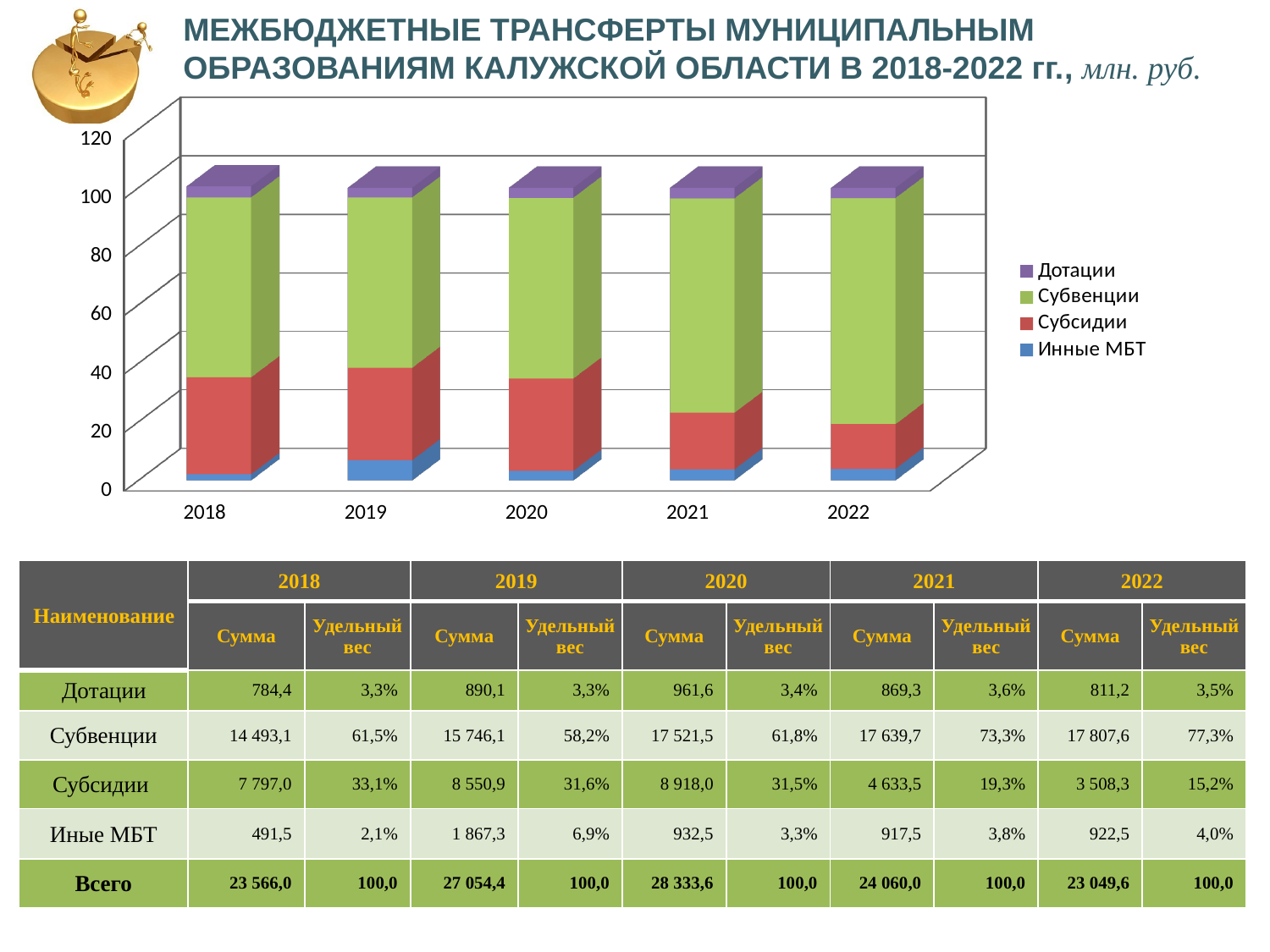
Which series has the smallest share in 2018? Иные МБТ What kind of chart is shown on the slide? Stacked bar chart In which year is the share of Субвенции the highest? 2022 How many series does the chart legend list? 4 Does the share of Субсидии rise or fall from 2018 to 2022? fall In 2019, which is larger: the share of Субвенции or the share of Субсидии? Субвенции Which series is shown in green in the chart? Субвенции Is the Субвенции segment of the 2022 bar greater or less than 60? greater Is the Субсидии segment of the 2018 bar greater or less than 20? greater How many years are shown along the x axis of the chart? 5 What is the share (удельный вес) of Субсидии in 2022? 15,2% What is the share (удельный вес) of Субвенции in 2021? 73,3%